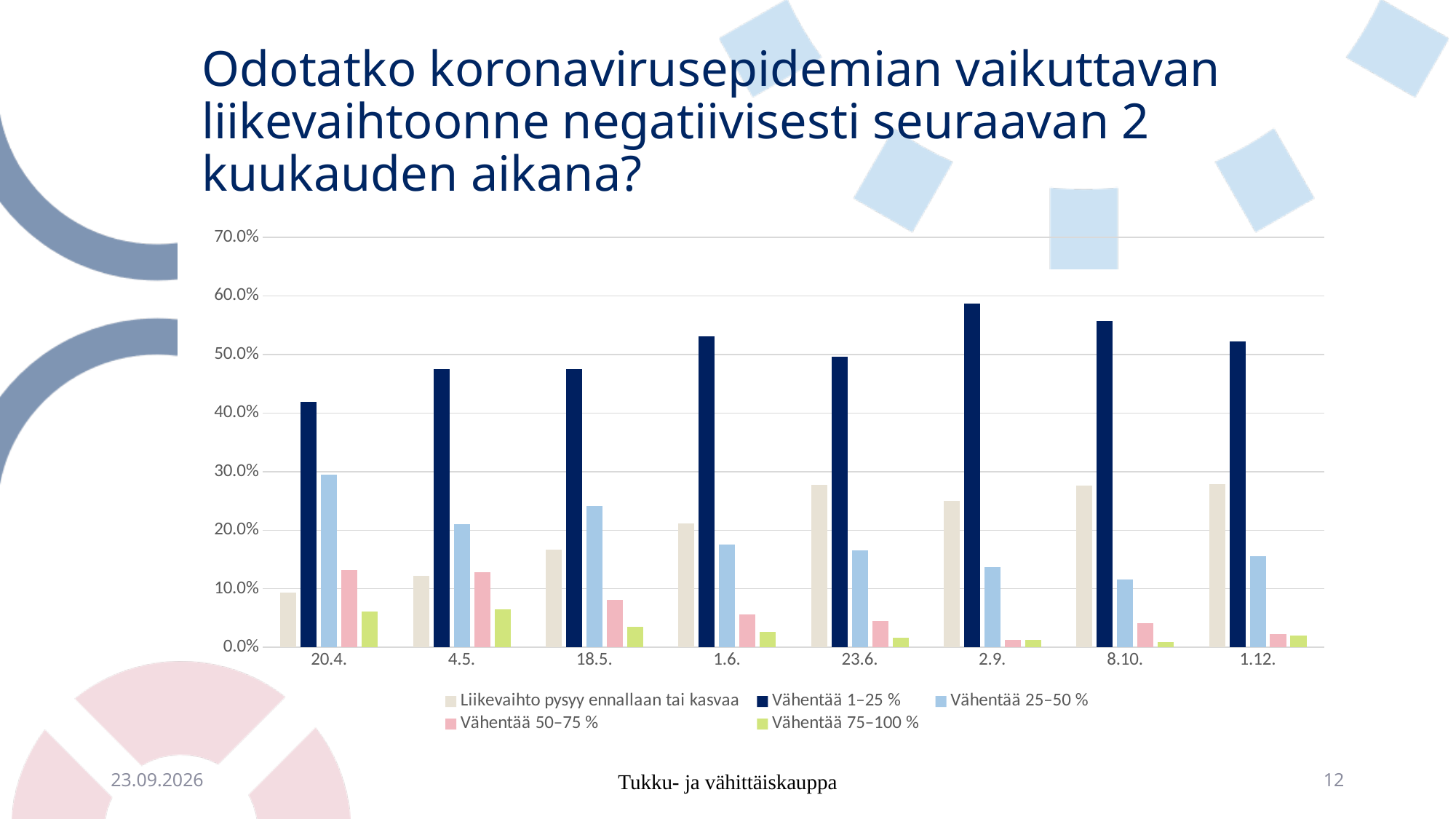
What kind of chart is shown on the slide? Bar chart Is the value for 'Vähentää 25–50 %' on 20.4. greater or less than 20.0%? greater How many date categories are shown on the x axis? 8 Does the 'Liikevaihto pysyy ennallaan tai kasvaa' series generally rise or fall from 20.4. to 1.12.? rise Is the value for 'Vähentää 1–25 %' on 20.4. greater or less than 50.0%? less For which date is the value of the 'Vähentää 1–25 %' series lowest? 20.4. How many series does the legend list? 5 For which date is the value of the 'Liikevaihto pysyy ennallaan tai kasvaa' series lowest? 20.4. Is the value for 'Vähentää 1–25 %' on 2.9. greater or less than 50.0%? greater For which date is the value of the 'Vähentää 1–25 %' series highest? 2.9. On 1.12., which is larger: 'Liikevaihto pysyy ennallaan tai kasvaa' or 'Vähentää 25–50 %'? Liikevaihto pysyy ennallaan tai kasvaa For which date is the value of the 'Vähentää 25–50 %' series highest? 20.4.